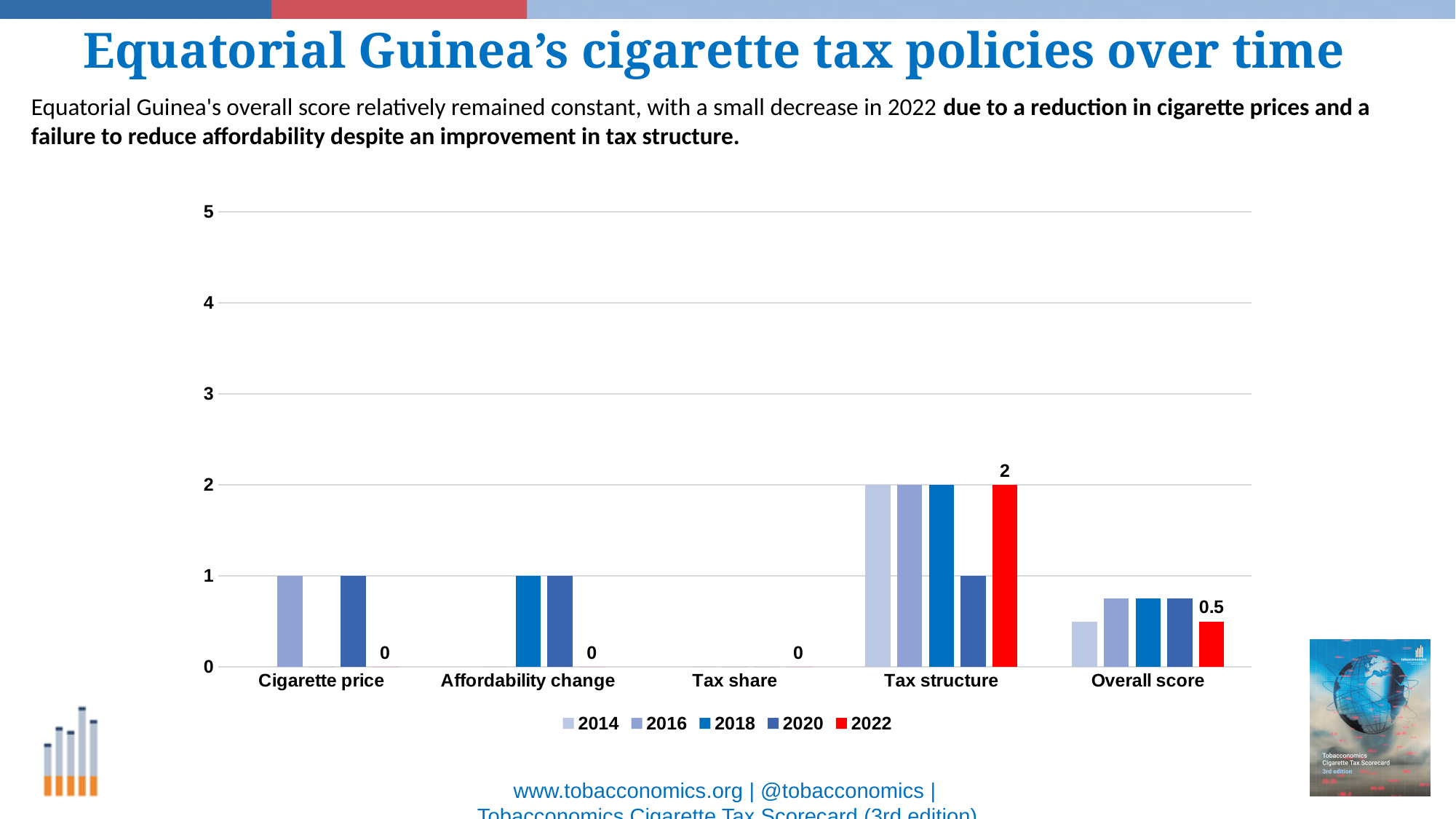
How many categories are shown on the x axis? 5 Which is larger in 2022: Tax structure or Overall score? Tax structure What is the value for Cigarette price in 2022? 0 What is the value for Tax structure in 2020? 1 What is the value for Tax structure in 2022? 2 Which category has the highest value in 2022? Tax structure How many series does the legend list? 5 What is the value for Affordability change in 2018? 1 What is the value for Overall score in 2022? 0.5 What kind of chart is shown on the slide? Bar chart What is the difference between the Tax structure values for 2022 and 2020? 1 Is the value for Overall score in 2016 greater or less than 1? less